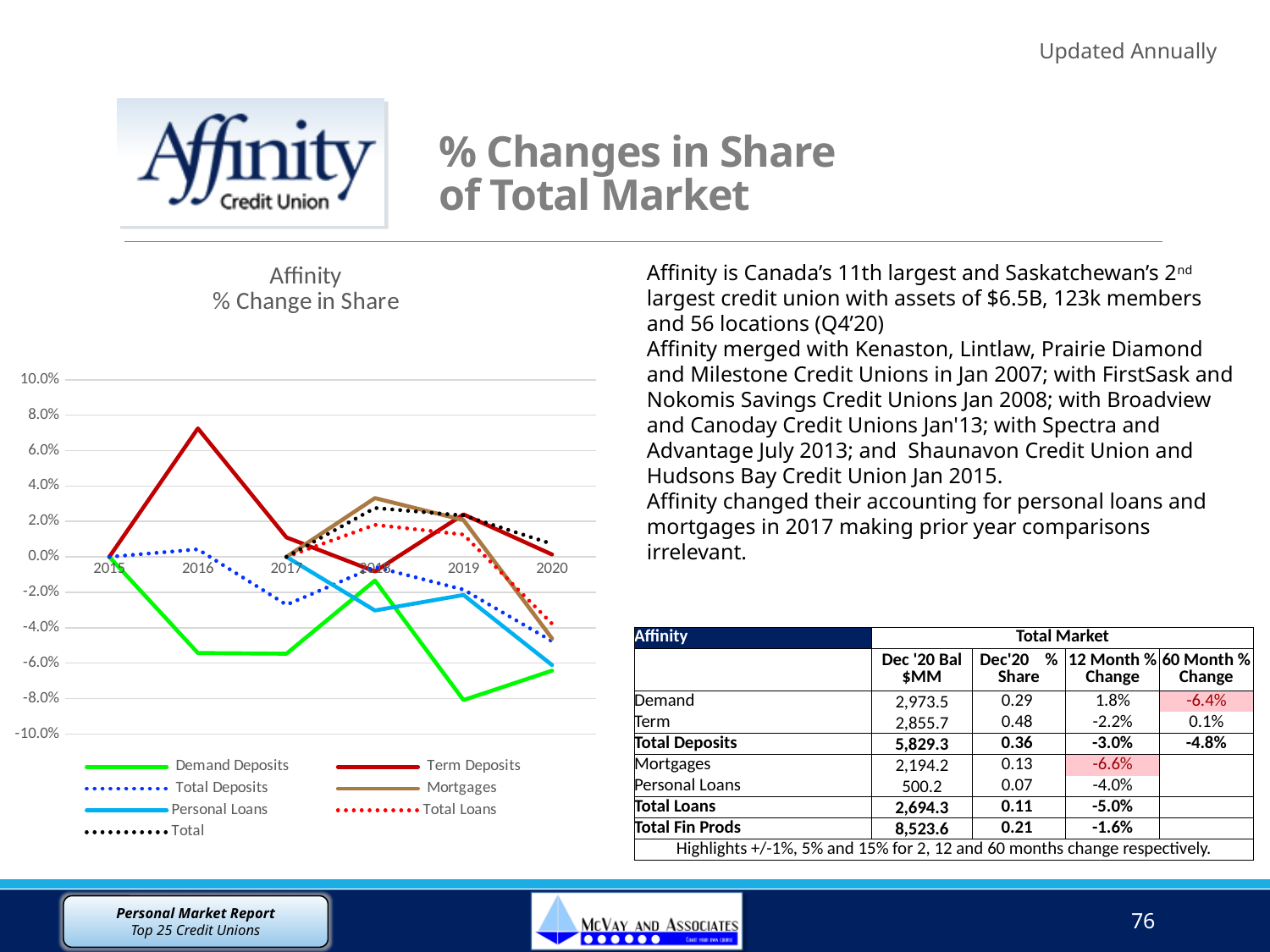
What kind of chart is shown on the slide? Line chart Does the Term Deposits line rise or fall from 2016 to 2018? Fall Is the value for Mortgages in 2018 greater or less than 2.0%? greater What colour is the Demand Deposits line in the chart? Green Is the value for Demand Deposits in 2019 greater or less than -6.0%? less Which series has the lowest value in 2019? Demand Deposits In 2019, which is higher: Demand Deposits or Personal Loans? Personal Loans How many years are shown along the x axis of the chart? 6 How many series does the chart legend list? 7 Which series has the highest value in 2016? Term Deposits What is the title of the chart? Affinity % Change in Share Is the value for Term Deposits in 2016 greater or less than 6.0%? greater